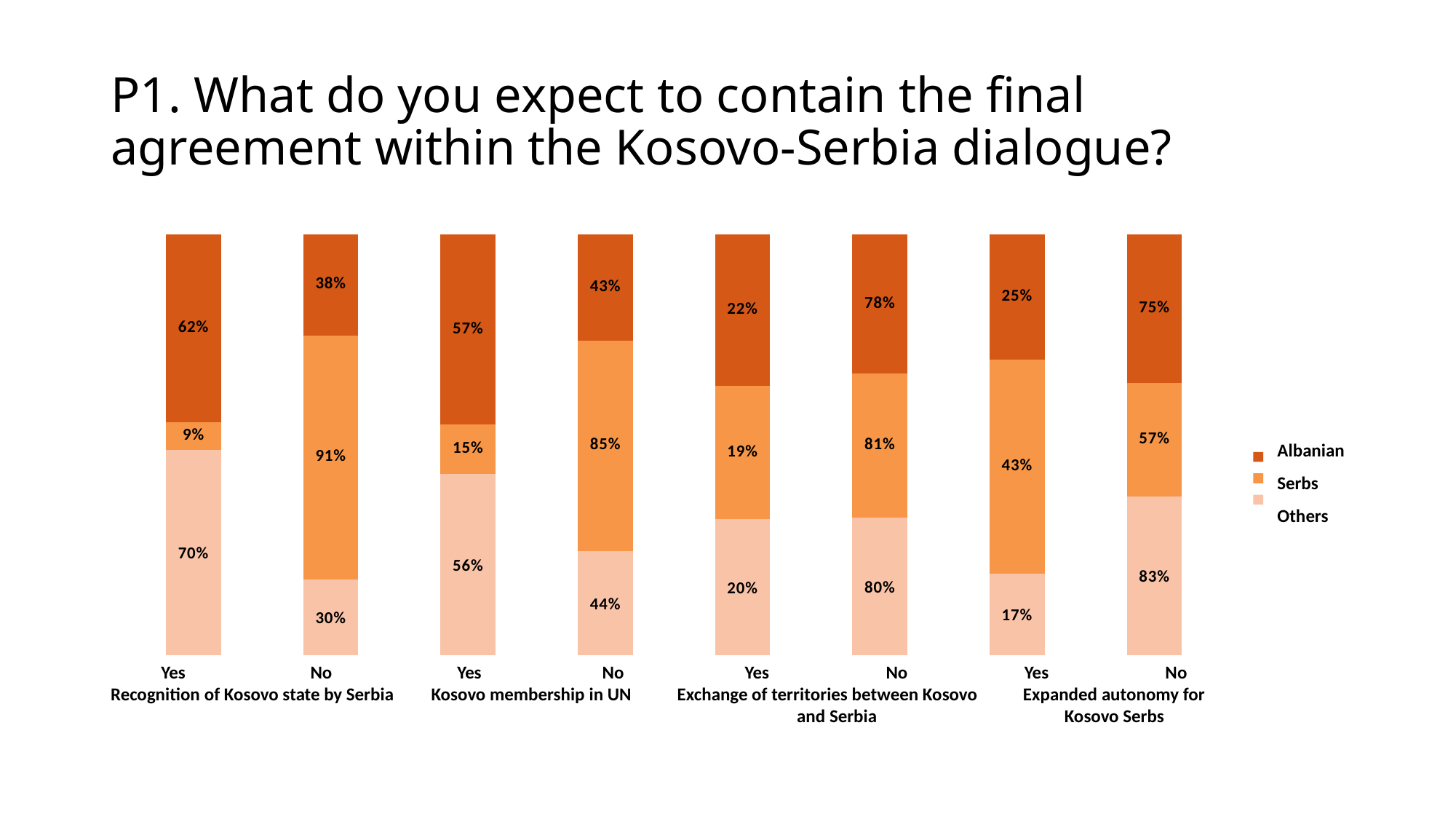
What is the difference between the Albanian 'No' value and the Albanian 'Yes' value under 'Exchange of territories between Kosovo and Serbia'? 56% How many series does the legend list? 3 What is the Serbs value for 'No' under 'Recognition of Kosovo state by Serbia'? 91% What is the Albanian value for 'Yes' under 'Recognition of Kosovo state by Serbia'? 62% Which 'Yes' bar has the lowest Serbs value? Recognition of Kosovo state by Serbia What is the Others value for 'Yes' under 'Kosovo membership in UN'? 56% What is the Serbs value for 'Yes' under 'Expanded autonomy for Kosovo Serbs'? 43% How many bars are plotted in the chart? 8 Which 'Yes' bar has the highest Albanian value? Recognition of Kosovo state by Serbia Under 'Kosovo membership in UN', is the Serbs 'No' value larger or the Albanian 'No' value larger? Serbs 'No' value (85%) What type of chart is shown on the slide? Stacked bar chart Which legend entry is shown in the darkest colour? Albanian